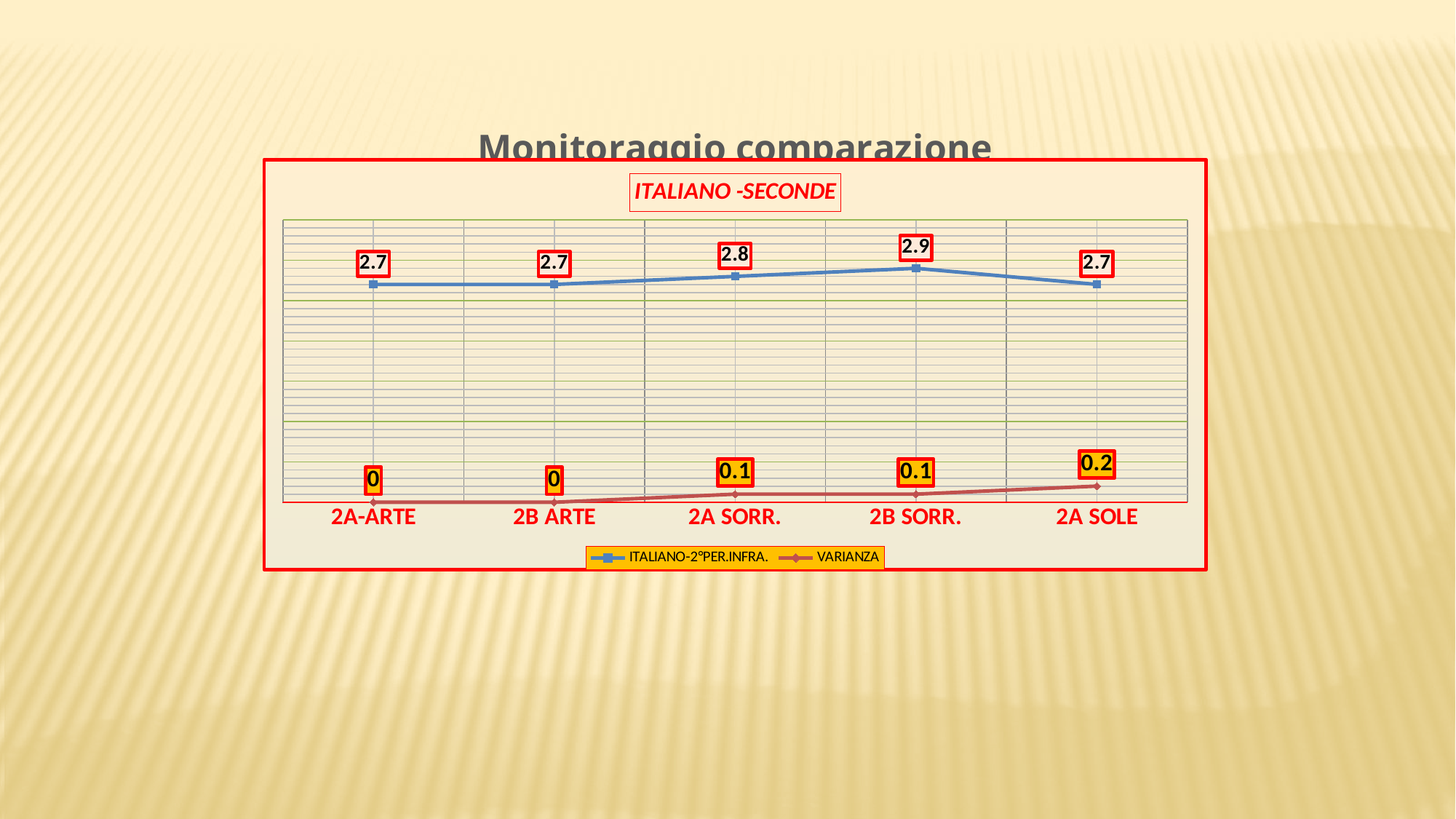
What is the value of ITALIANO-2°PER.INFRA. for 2B SORR.? 2.9 What is the VARIANZA value for 2B ARTE? 0 What kind of chart is shown? Line chart Which category has the highest VARIANZA value? 2A SOLE What is the difference between the ITALIANO-2°PER.INFRA. values for 2B SORR. and 2A SOLE? 0.2 Which is larger, the ITALIANO-2°PER.INFRA. value for 2A SORR. or for 2A-ARTE? 2A SORR. What is the title of the chart? ITALIANO -SECONDE How many series does the legend list? 2 Which category has the highest ITALIANO-2°PER.INFRA. value? 2B SORR. What is the VARIANZA value for 2A SOLE? 0.2 How many categories are shown on the x axis? 5 What is the value of ITALIANO-2°PER.INFRA. for 2A SORR.? 2.8